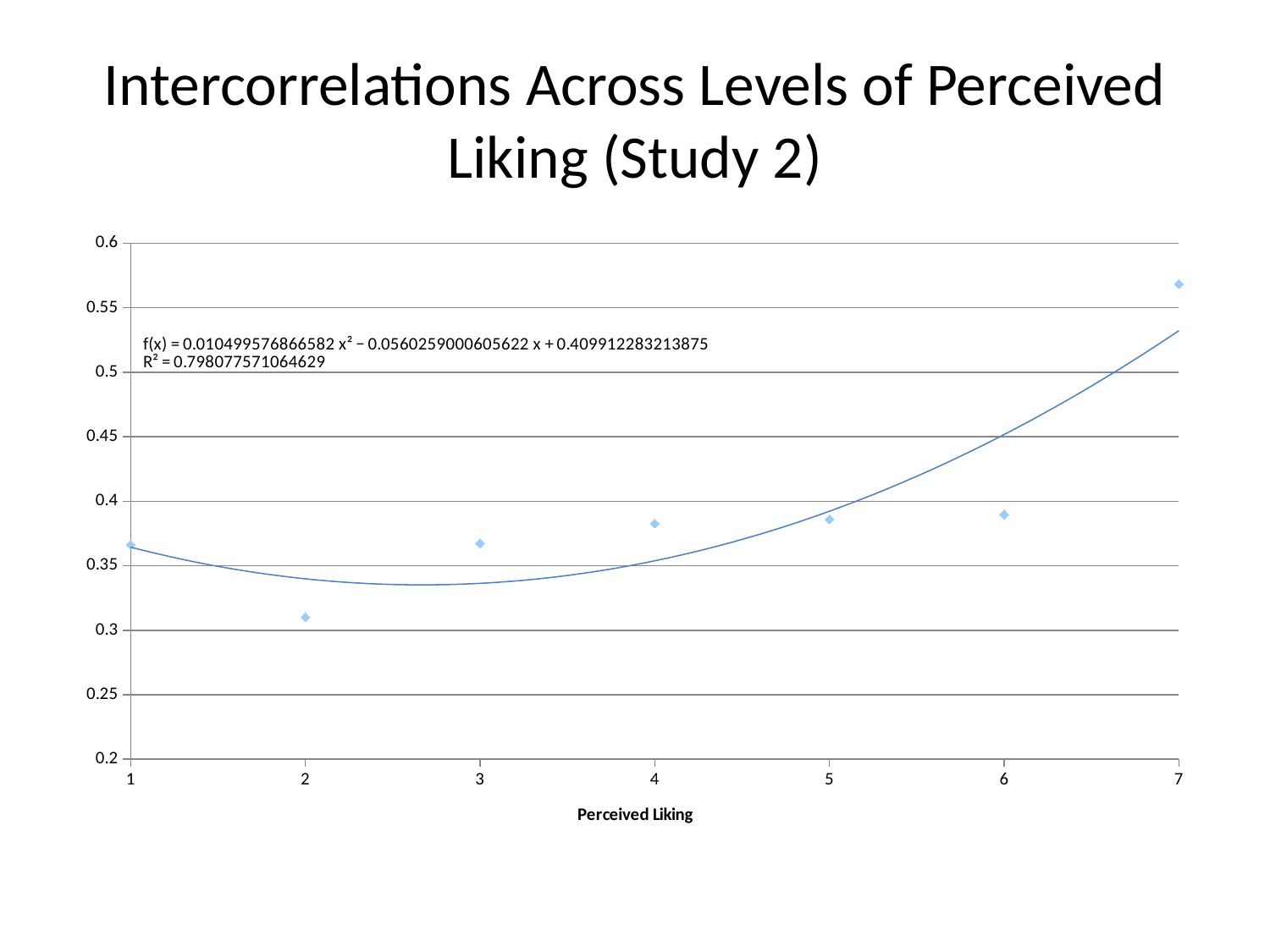
Do the plotted values generally rise or fall from Perceived Liking level 2 to level 7? rise Is the value at Perceived Liking level 4 greater or less than 0.4? less Is the value at Perceived Liking level 7 greater or less than 0.55? greater Is the value at Perceived Liking level 1 greater or less than 0.35? greater What R² value is printed on the chart for the trendline? 0.798077571064629 What is the title of the x axis? Perceived Liking At which Perceived Liking level is the plotted value lowest? 2 Which has the larger plotted value, Perceived Liking level 2 or level 3? level 3 What kind of chart is shown on the slide? scatter chart At which Perceived Liking level is the plotted value highest? 7 How many data points are plotted on the chart? 7